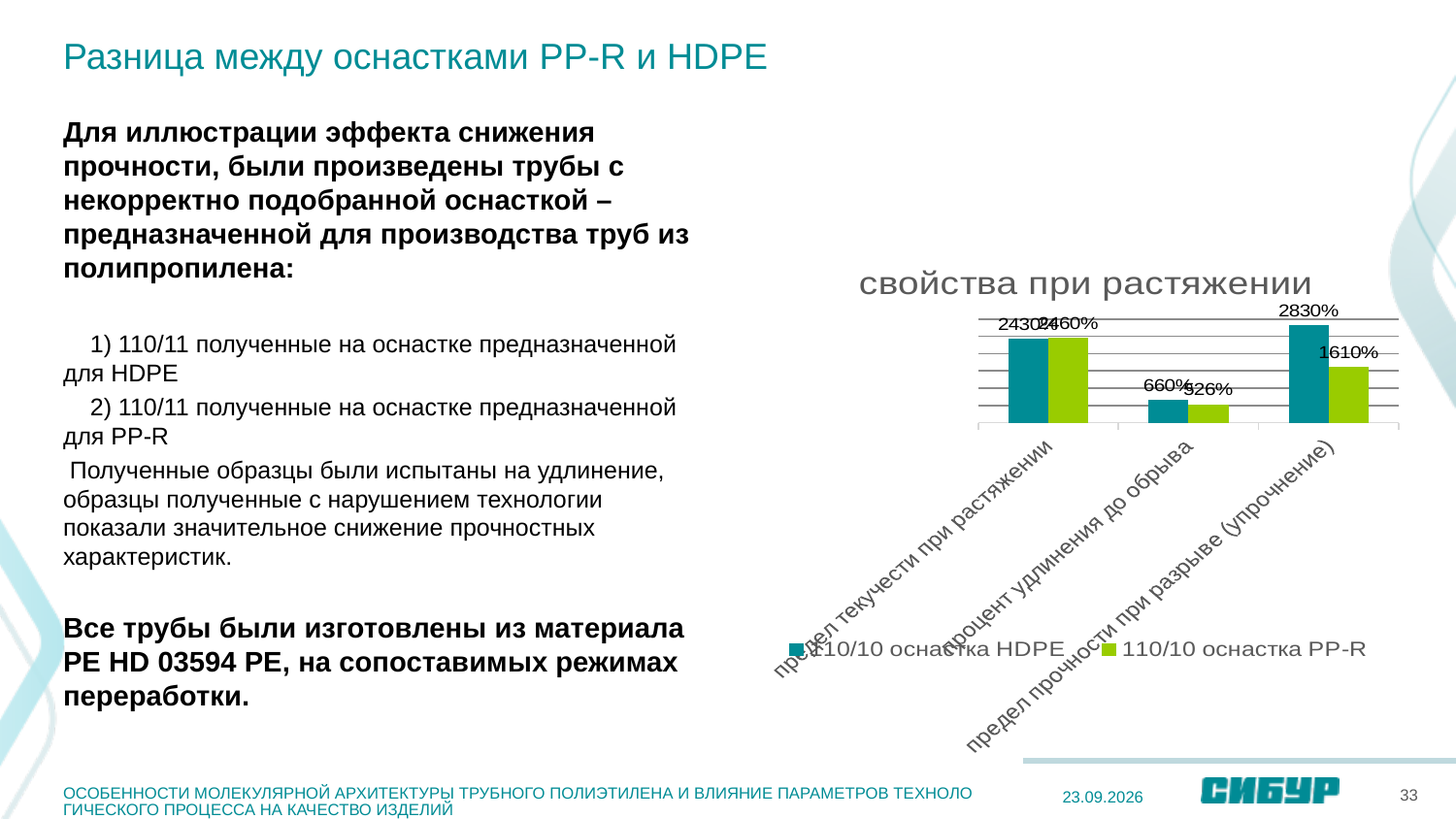
What is the difference between the HDPE and PP-R values in the category 'предел прочности при разрыве (упрочнение)'? 1220% What is the difference between the HDPE and PP-R values in the category 'процент удлинения до обрыва'? 134% In the category 'предел прочности при разрыве (упрочнение)', which series has the larger value? 110/10 оснастка HDPE What is the value for '110/10 оснастка HDPE' in the category 'процент удлинения до обрыва'? 660% What is the value for '110/10 оснастка HDPE' in the category 'предел прочности при разрыве (упрочнение)'? 2830% What is the value for '110/10 оснастка PP-R' in the category 'процент удлинения до обрыва'? 526% How many categories are shown on the x axis of the chart? 3 What is the title of the chart? свойства при растяжении How many series does the legend of the chart list? 2 What is the value for '110/10 оснастка PP-R' in the category 'предел прочности при разрыве (упрочнение)'? 1610% For the series '110/10 оснастка HDPE', which category has the lowest value? процент удлинения до обрыва What kind of chart is shown on the slide? bar chart